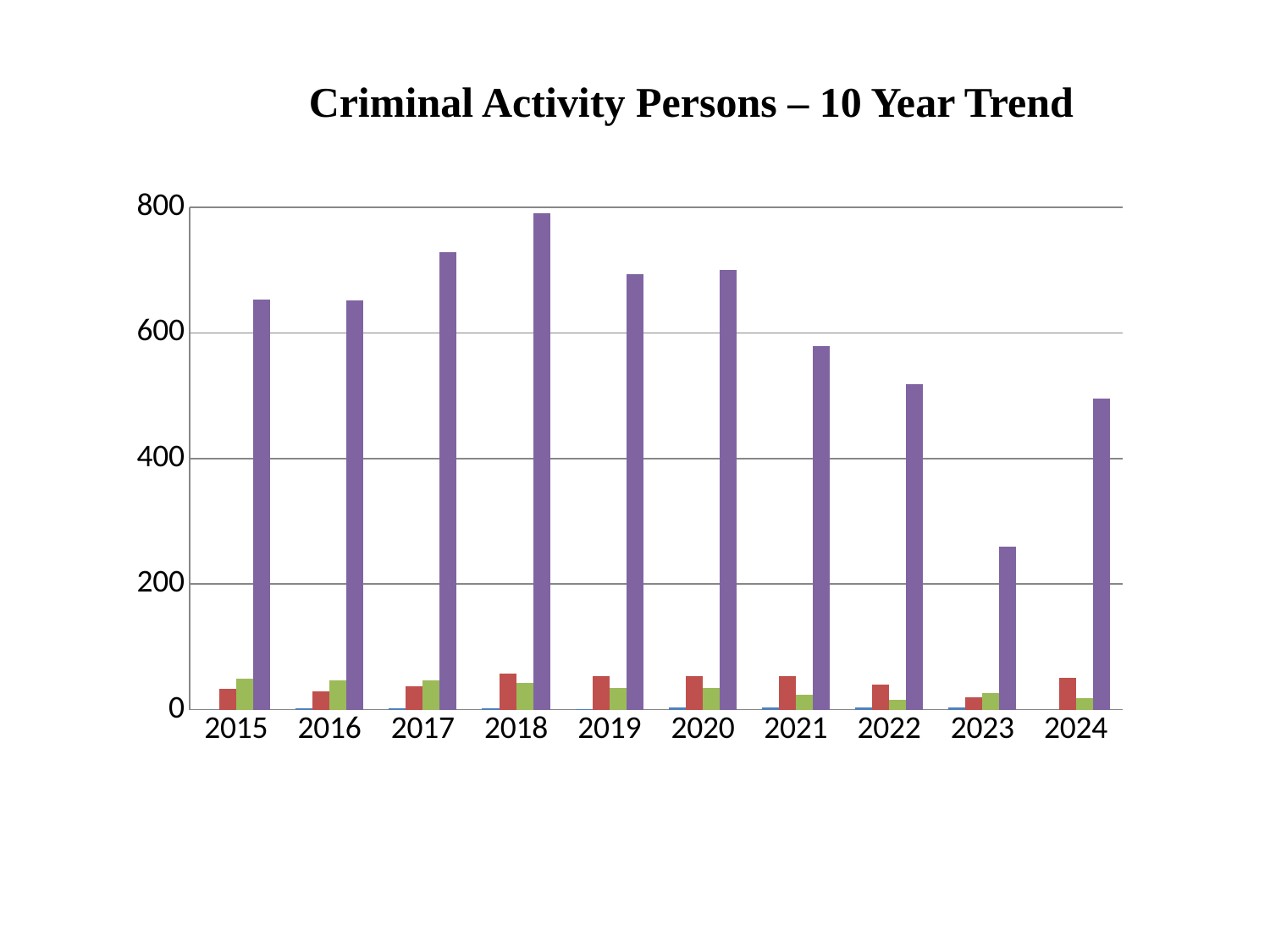
What is the title of the chart? Criminal Activity Persons – 10 Year Trend Is the value of the purple bar for 2022 greater or less than 400? greater What kind of chart is shown on the slide? bar chart How many years are shown along the x axis? 10 Which year has the larger purple bar, 2017 or 2021? 2017 In which year is the purple bar the tallest? 2018 In which year is the purple bar the shortest? 2023 Which colour of bar is the tallest in every year? purple Is the value of the purple bar for 2024 greater or less than 600? less Is the value of the purple bar for 2023 greater or less than 200? greater Do the purple bars rise or fall from 2020 to 2023? fall